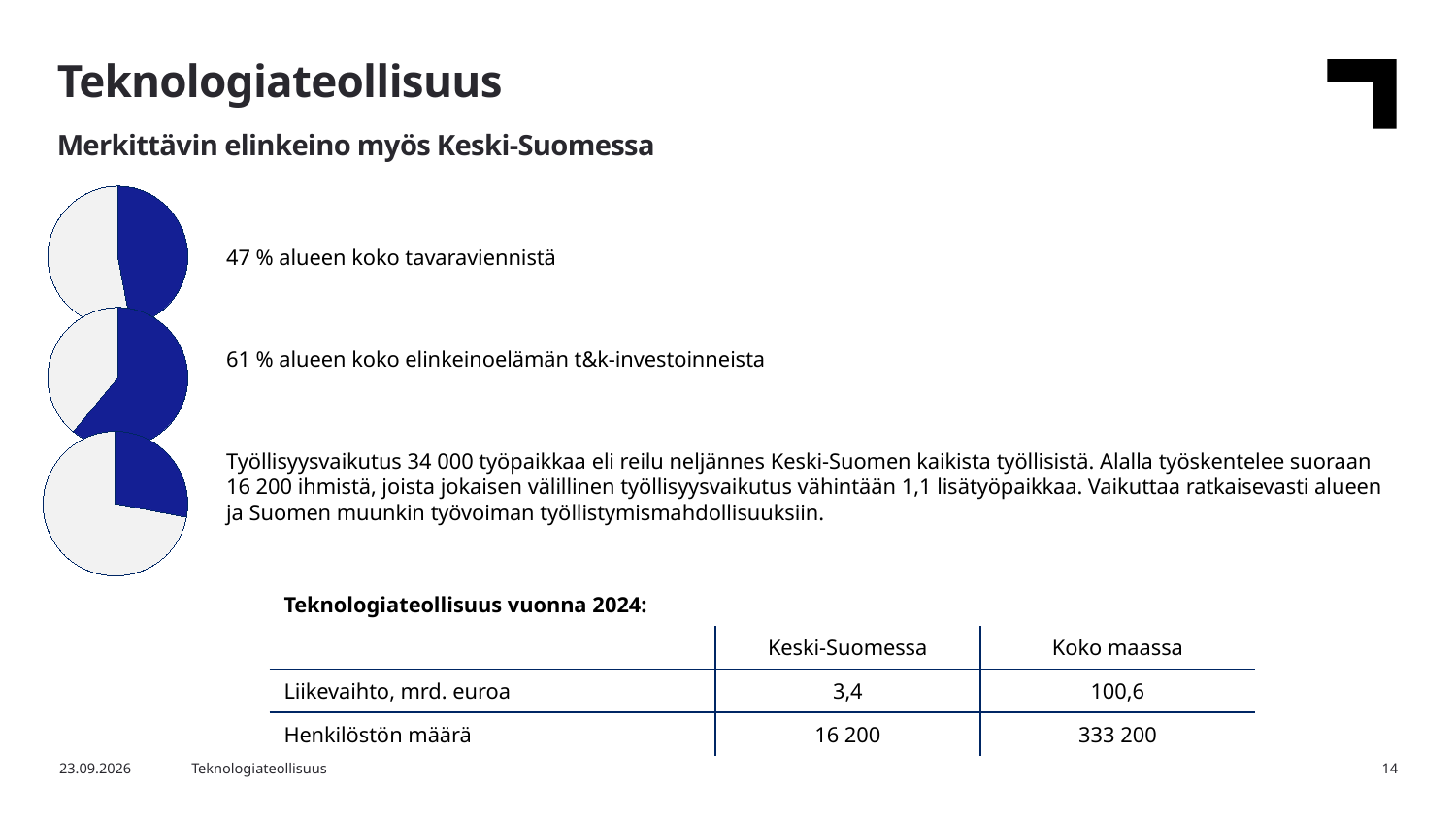
Of the three pie charts, which one has the largest blue slice? the middle one How many slices does the top pie chart have? 2 Which pie chart has the larger blue slice, the top one or the middle one? the middle one What colour is the highlighted slice in each of the pie charts? blue Which pie chart has the smaller blue slice, the top one or the bottom one? the bottom one According to the text next to the middle pie chart, what share of the region's business R&D investments does the blue slice represent? 61 % What kind of chart is the top chart on the left of the slide? pie chart According to the text next to the top pie chart, what share of the region's total goods exports does the blue slice represent? 47 % In the bottom pie chart, is the blue slice larger or smaller than half of the pie? smaller Of the three pie charts, which one has the smallest blue slice? the bottom one How many pie charts are shown on the slide? 3